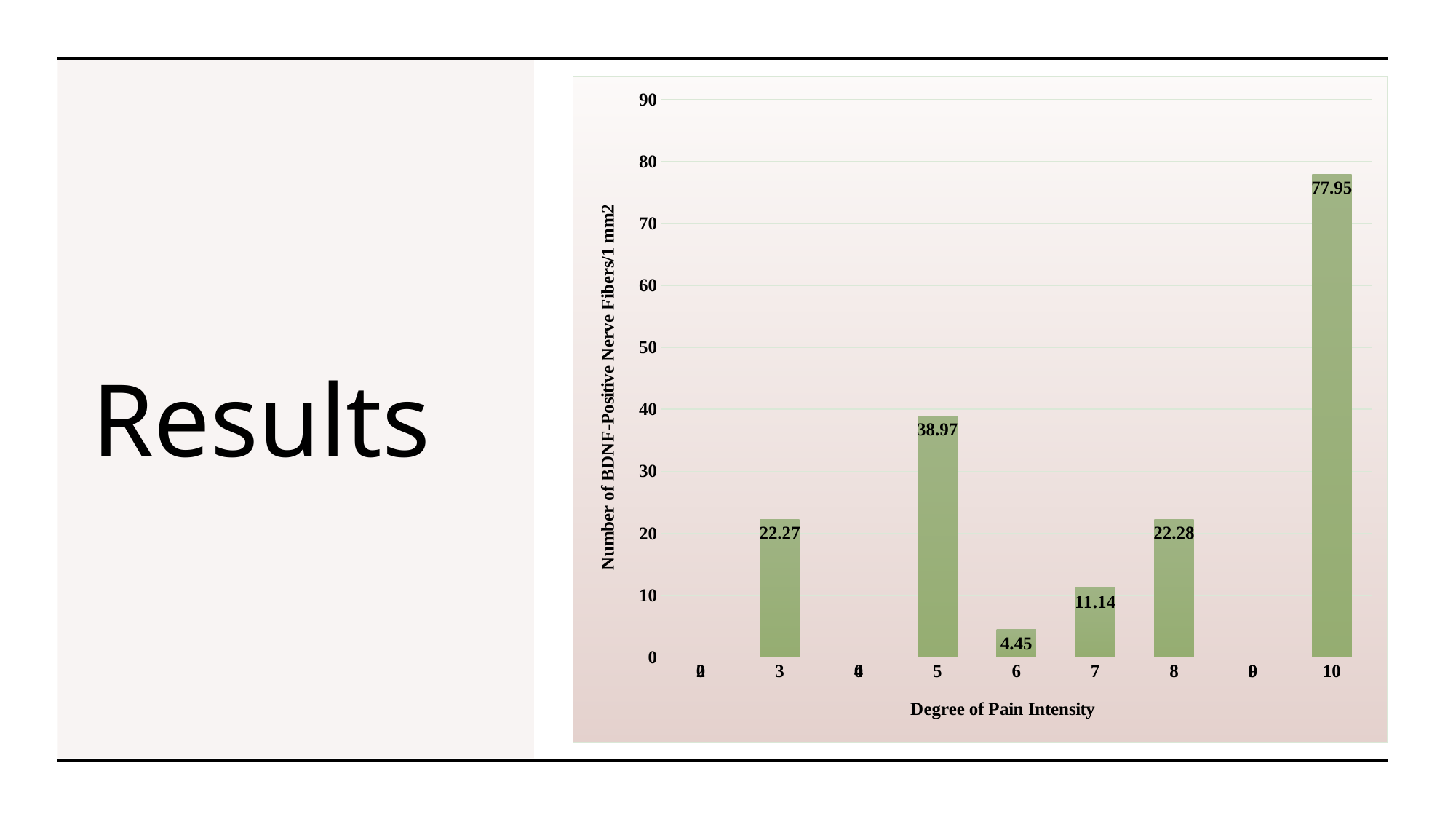
What is the difference between the values for pain intensity 7 and pain intensity 6? 6.69 What type of chart is shown on the slide? bar chart What is the value for pain intensity 6? 4.45 Which has a larger value, pain intensity 5 or pain intensity 8? 5 What is the value for pain intensity 5? 38.97 Is the value for pain intensity 10 greater or less than 70? greater What is the value for pain intensity 3? 22.27 What is the value for pain intensity 10? 77.95 Which degree of pain intensity has the highest number of BDNF-positive nerve fibers? 10 What is the value for pain intensity 7? 11.14 What is the title of the x axis? Degree of Pain Intensity What is the difference between the values for pain intensity 10 and pain intensity 5? 38.98